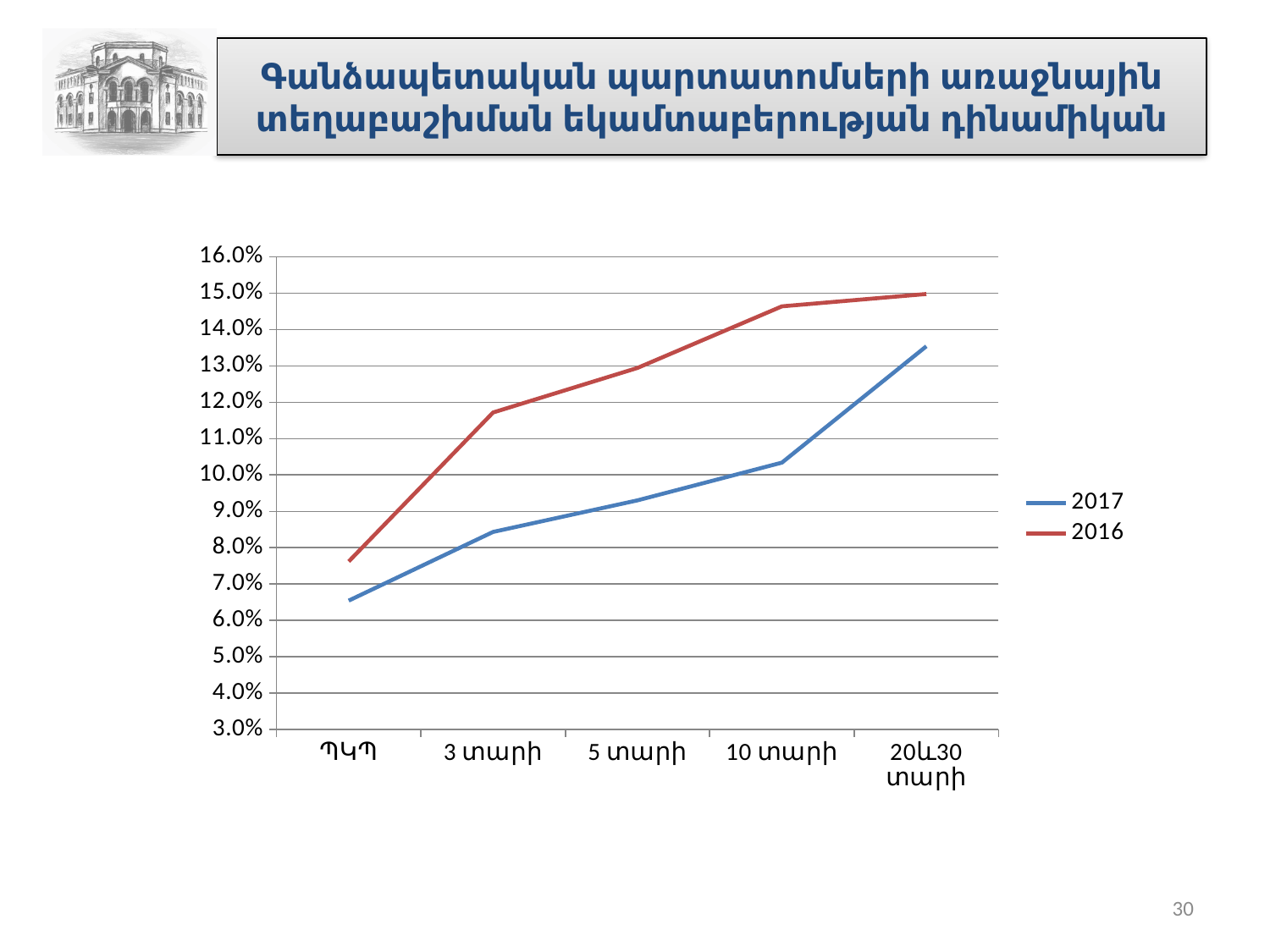
At 3 տարի, which series has the larger value, 2016 or 2017? 2016 Do the values for the 2017 series rise or fall along the x axis? rise How many series does the legend list? 2 Is the value for 2016 at 10 տարի greater or less than 14.0%? greater Is the value for 2017 at ՊԿՊ greater or less than 7.0%? less How many categories are shown along the x axis? 5 Which series is drawn in red? 2016 Which category has the highest value for the 2016 series? 20և30 տարի Which series is drawn in blue? 2017 Do the values for the 2016 series rise or fall along the x axis? rise Which category has the lowest value for the 2017 series? ՊԿՊ What kind of chart is shown on the slide? line chart